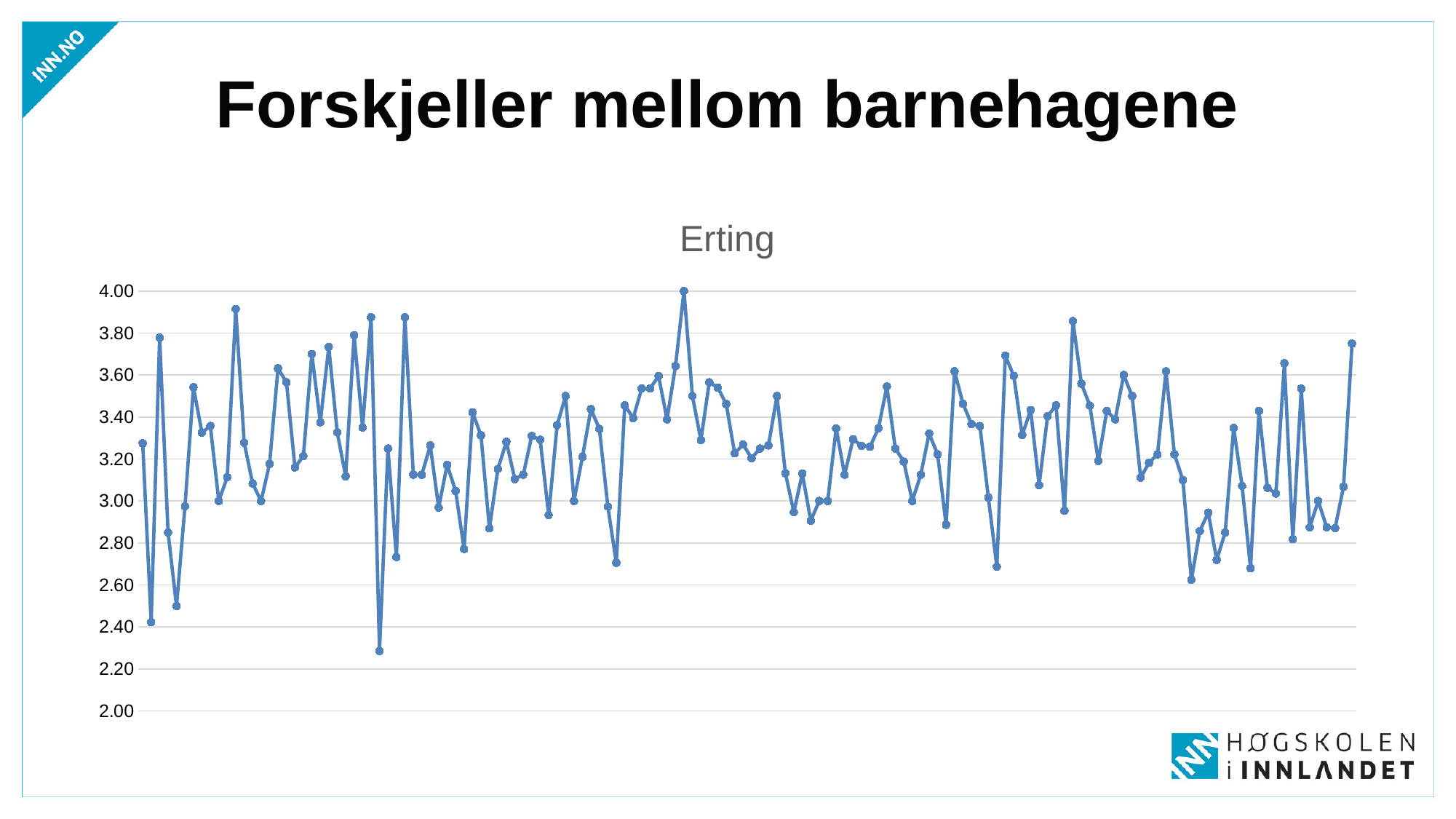
What is the title of the chart? Erting Is the lowest point on the line greater or less than 2.60? less What kind of chart is shown on the slide? line chart Is the lowest point on the line greater or less than 2.40? less What are the lowest and highest values shown on the vertical axis of the chart? 2.00 and 4.00 What is the highest value reached by the line in the chart? 4.00 Is the highest point on the line greater or less than 3.80? greater